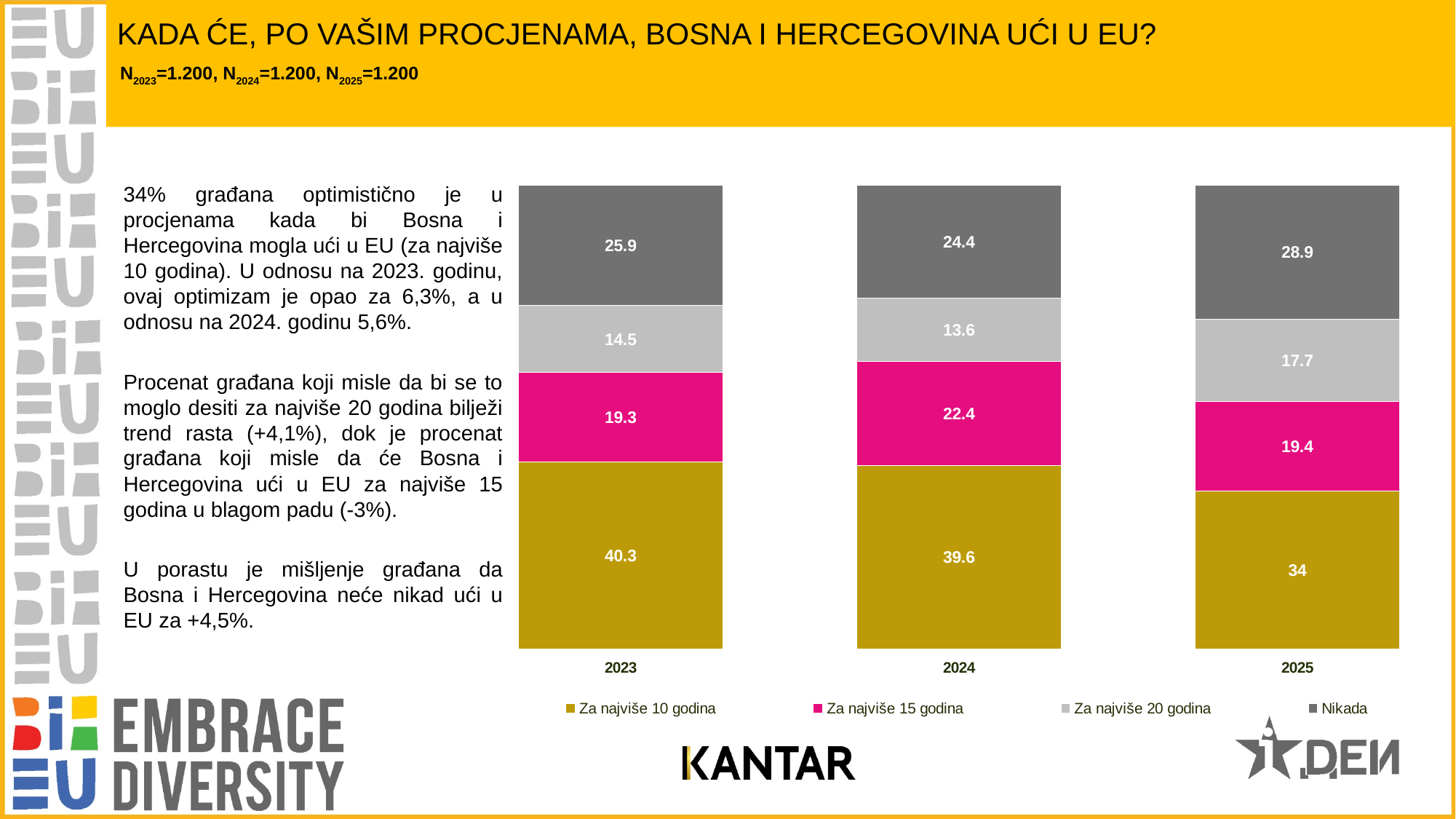
What type of chart is shown on the slide? Stacked bar chart In which year is the value for "Nikada" the lowest? 2024 How many series does the legend list? 4 What is the value for "Nikada" in 2024? 24.4 What is the value for "Za najviše 20 godina" in 2023? 14.5 What is the value for "Za najviše 10 godina" in 2025? 34 How many years (categories) are shown on the x axis? 3 In which year is the value for "Za najviše 10 godina" the highest? 2023 Does the value for "Za najviše 10 godina" rise or fall from 2023 to 2025? Fall What is the difference between the "Za najviše 10 godina" values for 2023 and 2025? 6.3 Which is larger: the "Za najviše 20 godina" value in 2025 or in 2024? 2025 What is the value for "Za najviše 15 godina" in 2024? 22.4